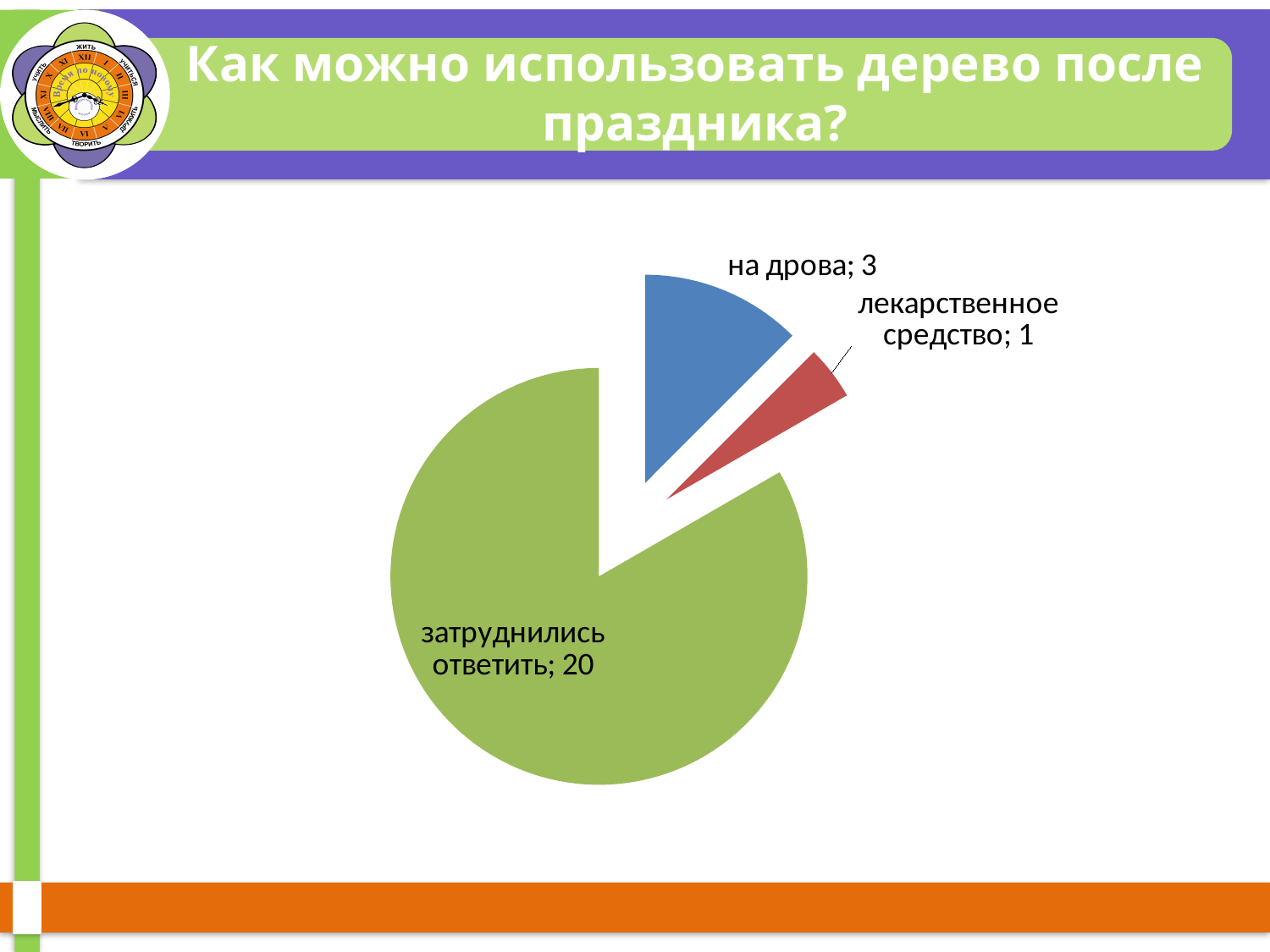
What is the value for "затруднились ответить"? 20 What is the difference between the values for "затруднились ответить" and "на дрова"? 17 Which category has the largest slice of the pie? затруднились ответить What kind of chart is shown on the slide? pie chart What is the value for "лекарственное средство"? 1 How many slices does the pie chart have? 3 Which category has the smallest slice of the pie? лекарственное средство What share of the pie does "на дрова" represent? 12.5% What is the difference between the values for "на дрова" and "лекарственное средство"? 2 What is the value for "на дрова"? 3 What is the total of all the values in the pie chart? 24 Which is larger, the value for "на дрова" or the value for "лекарственное средство"? на дрова